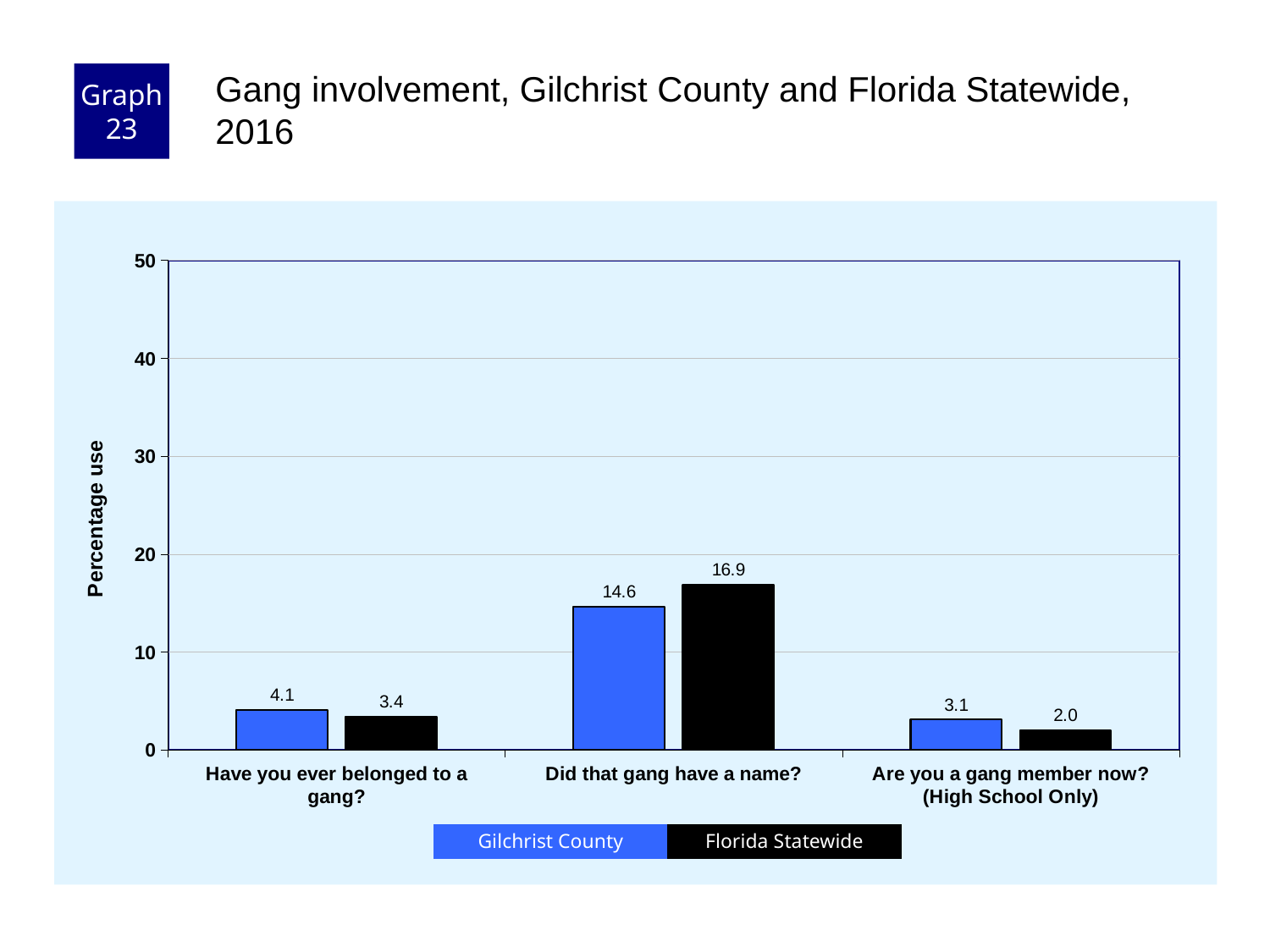
Which question has the highest Gilchrist County value? Did that gang have a name? Is the Gilchrist County value for "Did that gang have a name?" greater or less than 10? greater How many series does the legend list? 2 How many questions (categories) are shown on the x axis? 3 What is the Florida Statewide value for "Did that gang have a name?"? 16.9 For "Have you ever belonged to a gang?", which is larger: Gilchrist County or Florida Statewide? Gilchrist County What is the difference between the Florida Statewide and Gilchrist County values for "Did that gang have a name?"? 2.3 What is the label of the y axis? Percentage use What kind of chart is shown on the slide? Bar chart What is the Florida Statewide value for "Are you a gang member now? (High School Only)"? 2.0 Which question has the lowest Florida Statewide value? Are you a gang member now? (High School Only) What is the Gilchrist County value for "Have you ever belonged to a gang?"? 4.1